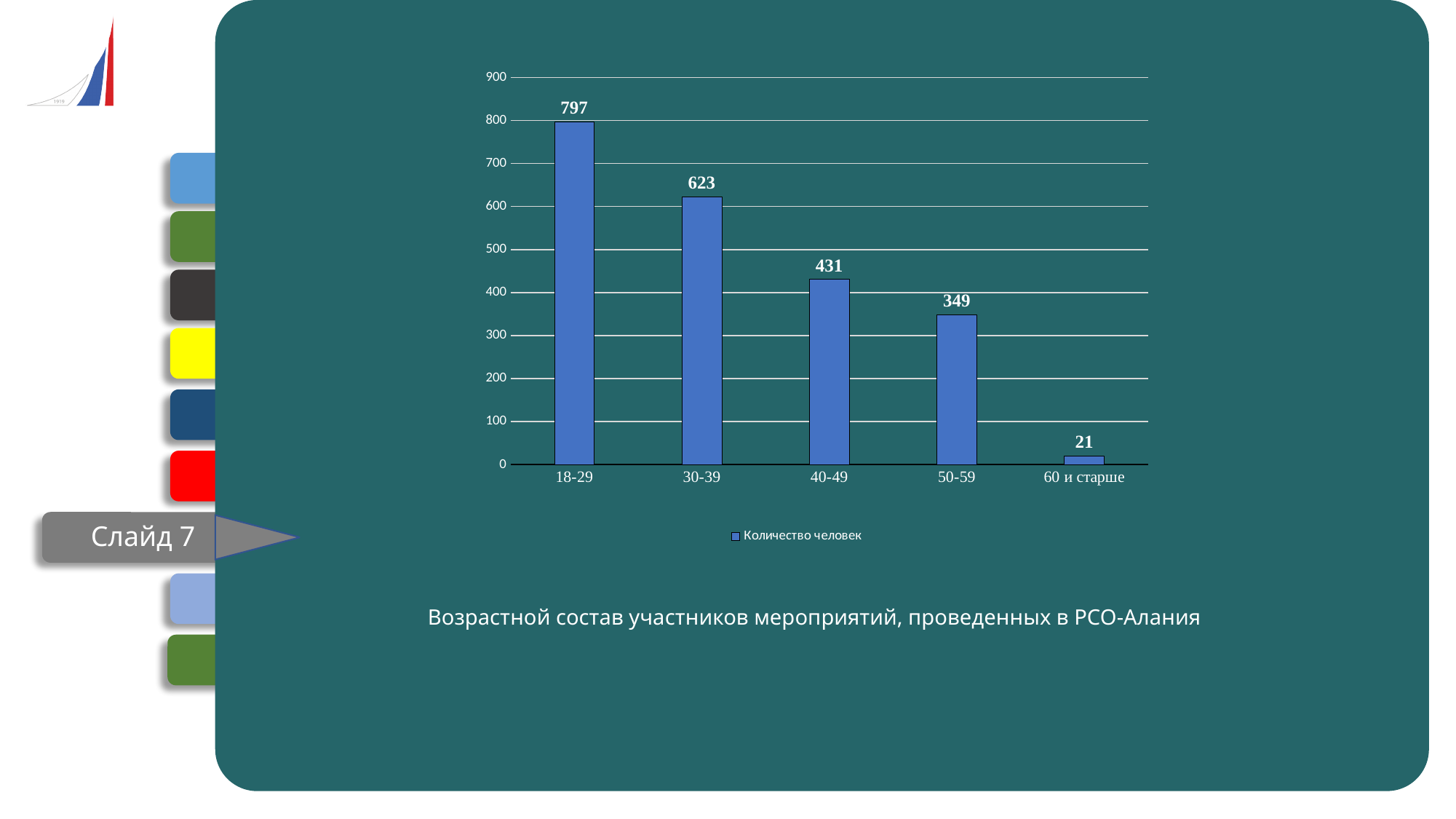
What is the legend entry for the series? Количество человек What kind of chart is shown on the slide? bar chart Which is larger, the value for 40-49 or the value for 50-59? 40-49 Which age group has the highest value? 18-29 How many age groups are shown on the x axis? 5 What is the value for the 60 и старше age group? 21 What is the value for the 40-49 age group? 431 What is the value for the 18-29 age group? 797 How many series does the legend list? 1 What is the difference between the values for 30-39 and 50-59? 274 Which age group has the lowest value? 60 и старше Do the values rise or fall from left to right along the x axis? fall